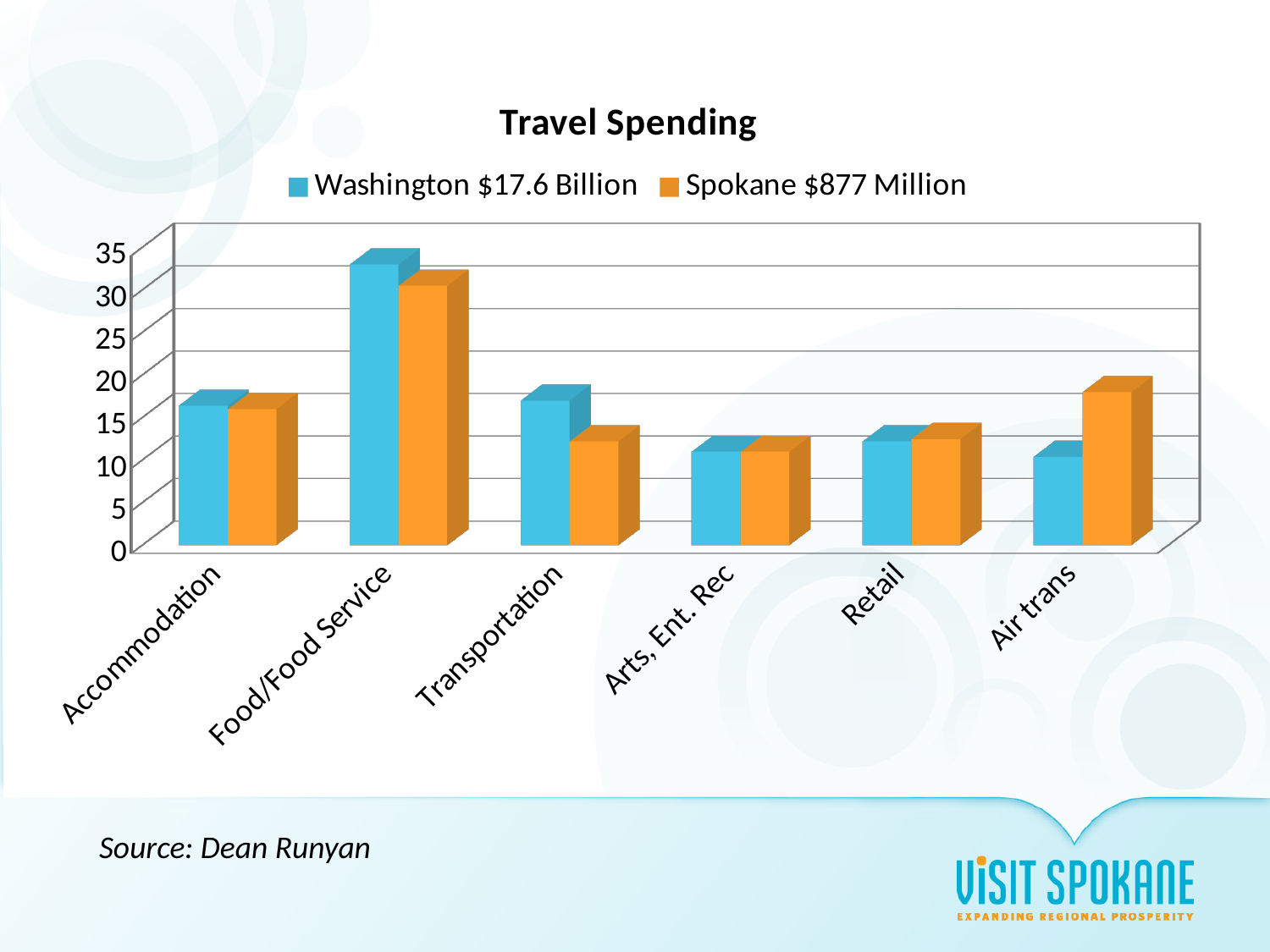
Which category has the highest value for the Washington $17.6 Billion series? Food/Food Service Is the Spokane $877 Million value for Air trans greater or less than 15? greater What is the title of the chart? Travel Spending Which category has the highest value for the Spokane $877 Million series? Food/Food Service Is the Washington $17.6 Billion value for Air trans greater or less than 15? less Is the Spokane $877 Million value for Transportation greater or less than 15? less For Transportation, which series has the larger value, Washington $17.6 Billion or Spokane $877 Million? Washington $17.6 Billion How many series does the legend list? 2 How many categories are shown on the x axis? 6 For Air trans, which series has the larger value, Washington $17.6 Billion or Spokane $877 Million? Spokane $877 Million What kind of chart is shown on the slide? bar chart